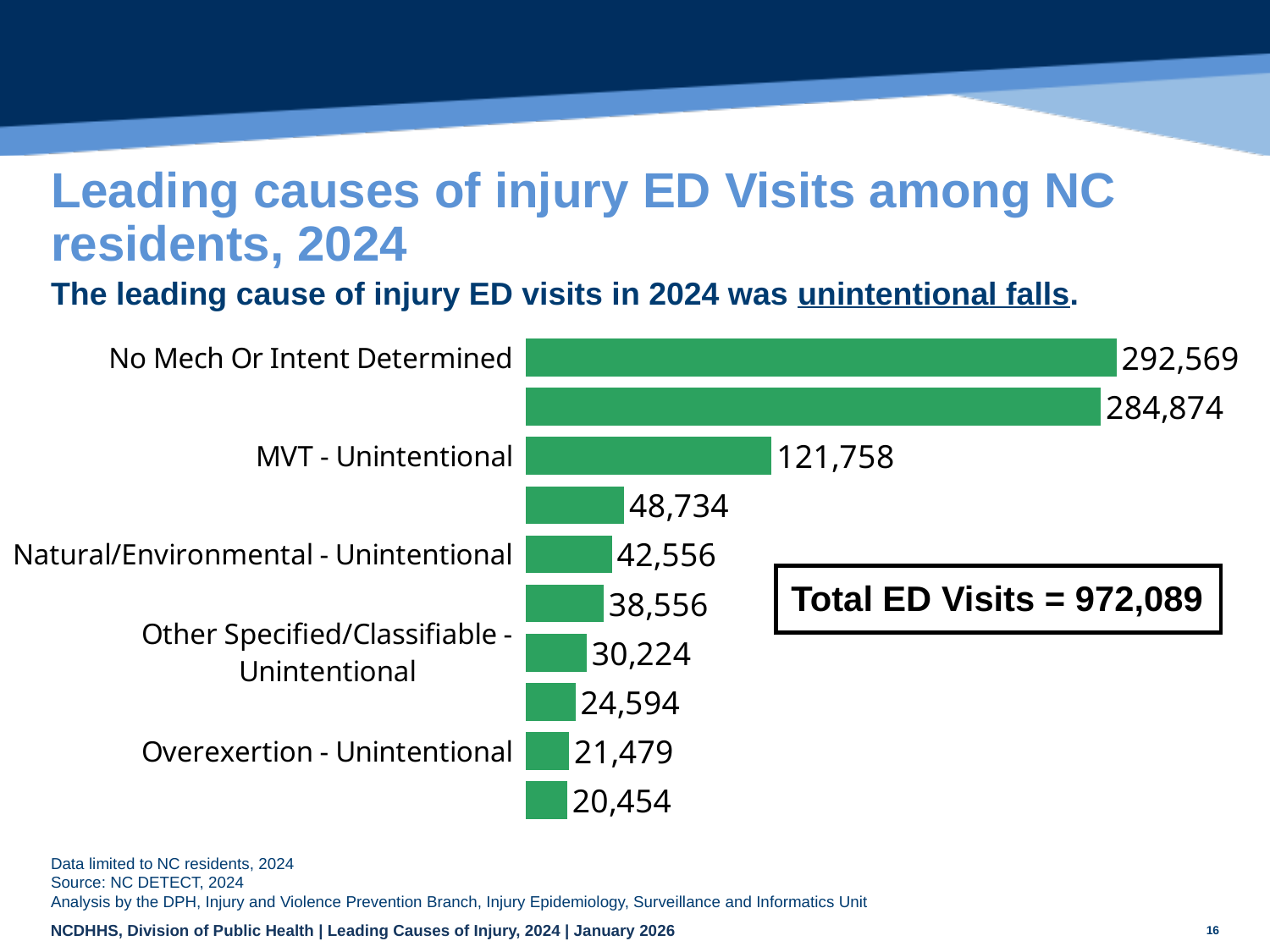
What is the value for MVT - Unintentional? 121,758 What kind of chart is shown on the slide? bar chart What is the value of the shortest bar in the chart? 20,454 What total number of ED visits is stated in the box on the chart? 972,089 Which is larger, the value for MVT - Unintentional or the value for Natural/Environmental - Unintentional? MVT - Unintentional What is the difference between the values for Other Specified/Classifiable - Unintentional and Overexertion - Unintentional? 8,745 What is the difference between the values for No Mech Or Intent Determined and MVT - Unintentional? 170,811 How many bars does the chart show? 10 Which category has the highest value? No Mech Or Intent Determined What is the value for Natural/Environmental - Unintentional? 42,556 What is the value for Overexertion - Unintentional? 21,479 What is the value for No Mech Or Intent Determined? 292,569